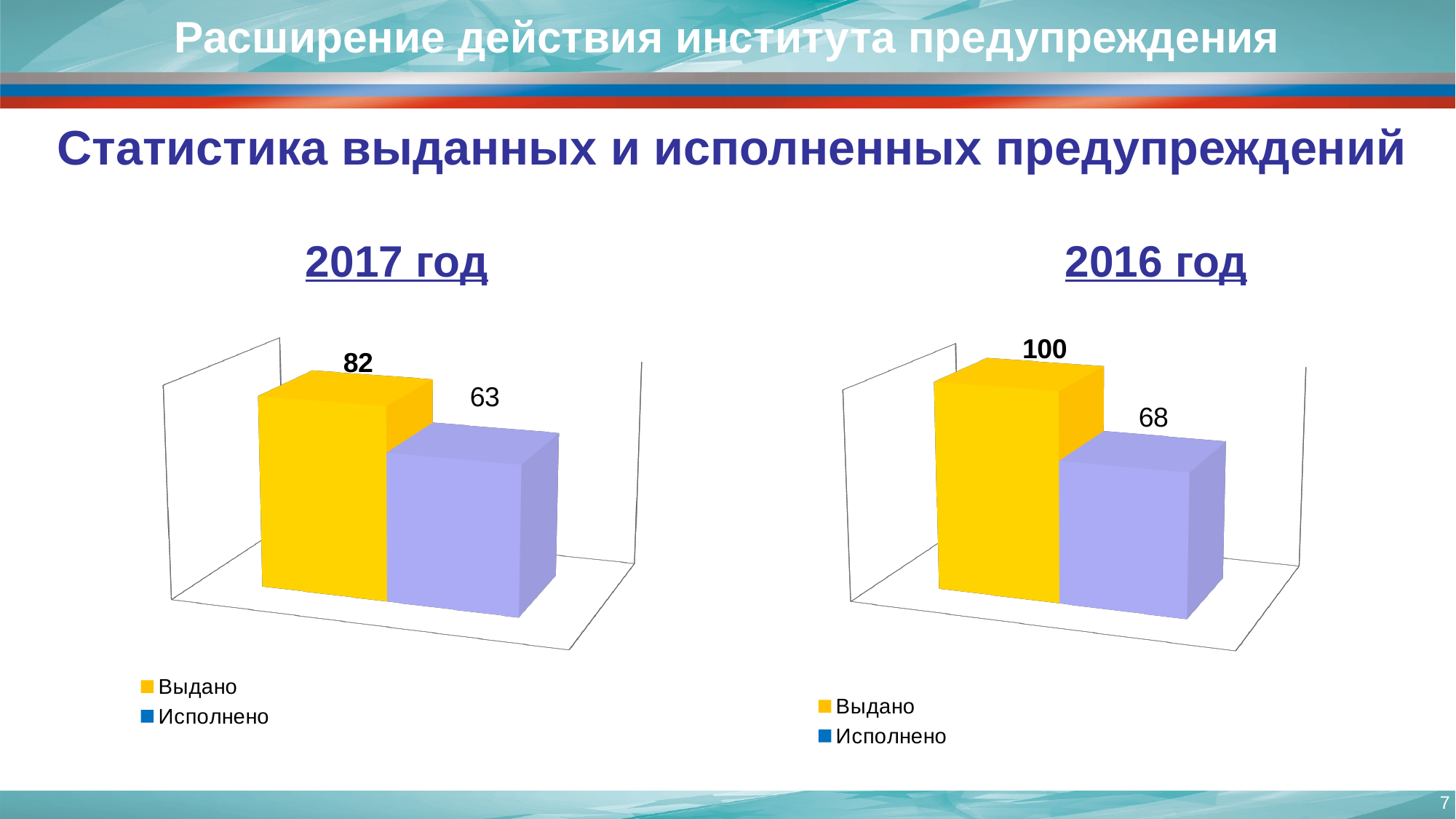
In the 2016 год chart, what is the value for Выдано? 100 What kind of chart is the 2017 год chart? bar chart In the 2017 год chart, what is the value for Выдано? 82 In the 2017 год chart, what is the value for Исполнено? 63 How many series does the legend of the 2016 год chart list? 2 In the 2016 год chart, which series has the lower value? Исполнено Is the value for Выдано in the 2017 год chart larger or smaller than the value for Выдано in the 2016 год chart? smaller In the 2017 год chart, what colour is the Выдано bar? yellow In the 2017 год chart, which series has the higher value? Выдано In the 2016 год chart, what is the value for Исполнено? 68 In the 2016 год chart, what is the difference between Выдано and Исполнено? 32 In the 2017 год chart, what is the difference between Выдано and Исполнено? 19